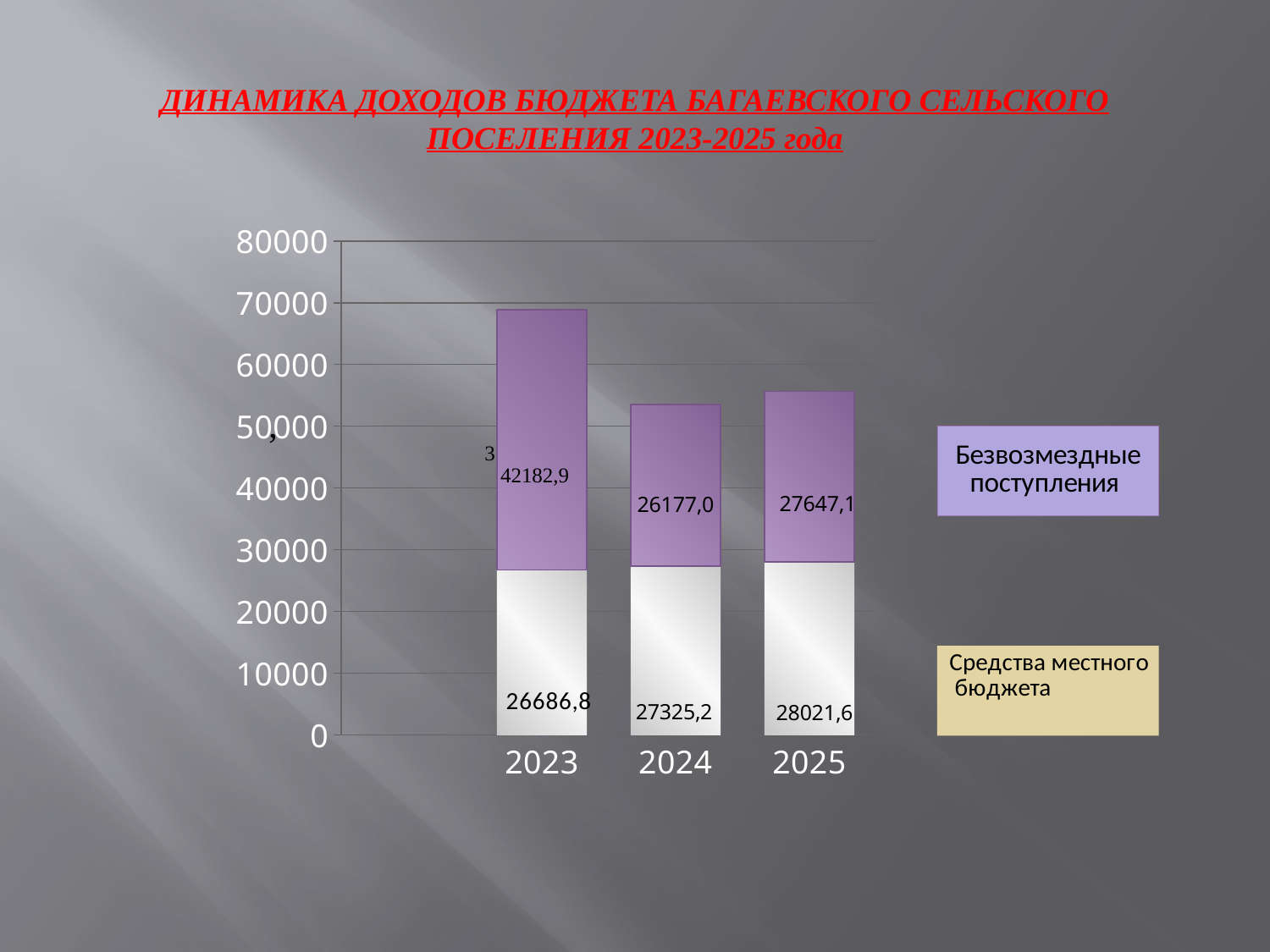
In which year is Безвозмездные поступления highest? 2023 How many series does the legend list? 2 What is the value of Безвозмездные поступления for 2024? 26177,0 What is the value of Безвозмездные поступления for 2023? 42182,9 Which is larger in 2025: Безвозмездные поступления or Средства местного бюджета? Средства местного бюджета How many years are shown on the x axis? 3 What type of chart is shown on the slide? stacked bar chart What is the difference between Безвозмездные поступления in 2023 and in 2024? 16005,9 What is the value of Средства местного бюджета for 2025? 28021,6 What is the total of the stacked bar for 2024? 53502,2 In which year is Средства местного бюджета lowest? 2023 What is the value of Средства местного бюджета for 2023? 26686,8